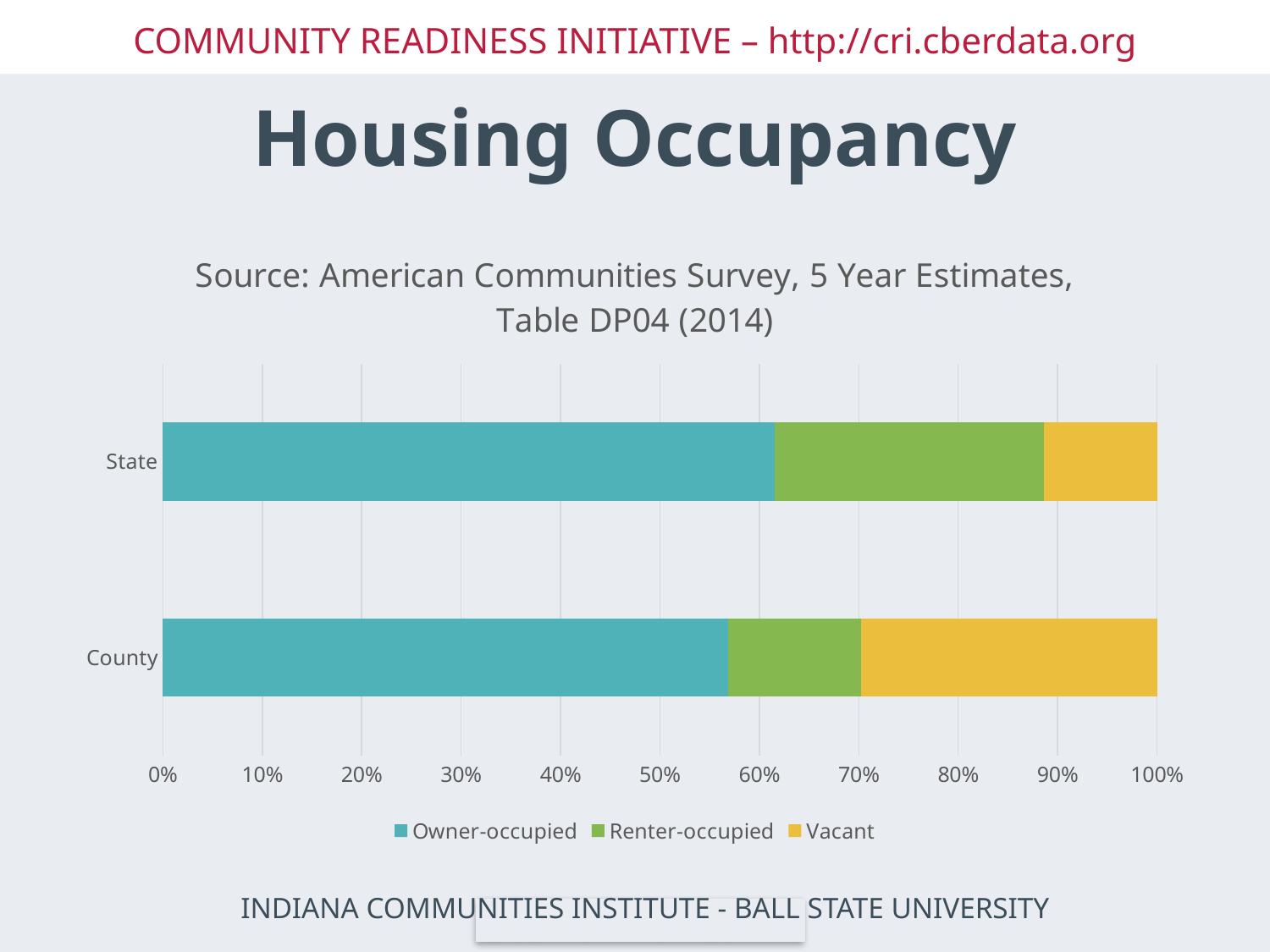
How many series does the legend list? 3 Is the Owner-occupied value for County greater or less than 60%? less What is the title of the chart? Source: American Communities Survey, 5 Year Estimates, Table DP04 (2014) Is the Vacant share for County greater or less than 20%? greater Which has the larger Vacant share, State or County? County Is the Owner-occupied value for State greater or less than 60%? greater What is the total of the stacked bar for County? 100% What are the three series listed in the legend? Owner-occupied, Renter-occupied, Vacant How many categories are plotted on the chart? 2 What kind of chart is shown on the slide? bar chart Which has the larger Renter-occupied share, State or County? State